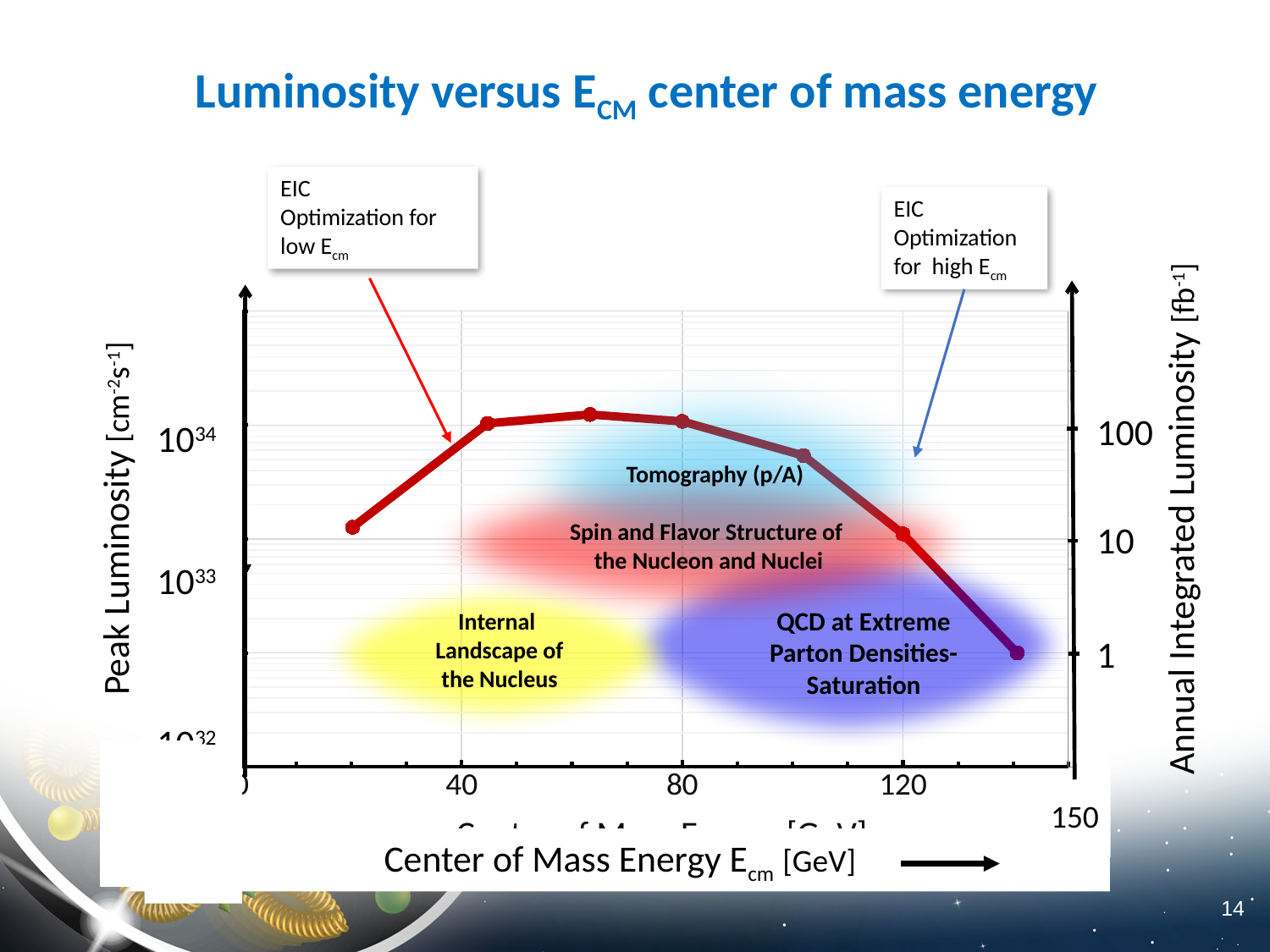
Is the peak luminosity at 120 GeV greater or less than 10^34 cm^-2 s^-1? less Is the peak luminosity at the highest plotted center of mass energy (about 140 GeV) greater or less than 10^33 cm^-2 s^-1? less Is the peak luminosity at 120 GeV greater or less than 10^33 cm^-2 s^-1? greater How does the peak luminosity change as the center of mass energy increases from 40 GeV to 140 GeV? It rises slightly to a maximum near 60 GeV, then falls Which has the larger peak luminosity: 80 GeV or 120 GeV center of mass energy? 80 GeV What is the title of the chart? Luminosity versus ECM center of mass energy Does the peak luminosity reach its maximum at the lowest, the highest, or an intermediate center of mass energy? intermediate What kind of chart is shown on the slide? line chart How many data points are plotted on the luminosity curve? 7 What quantity is shown on the right-hand vertical axis? Annual Integrated Luminosity [fb-1]